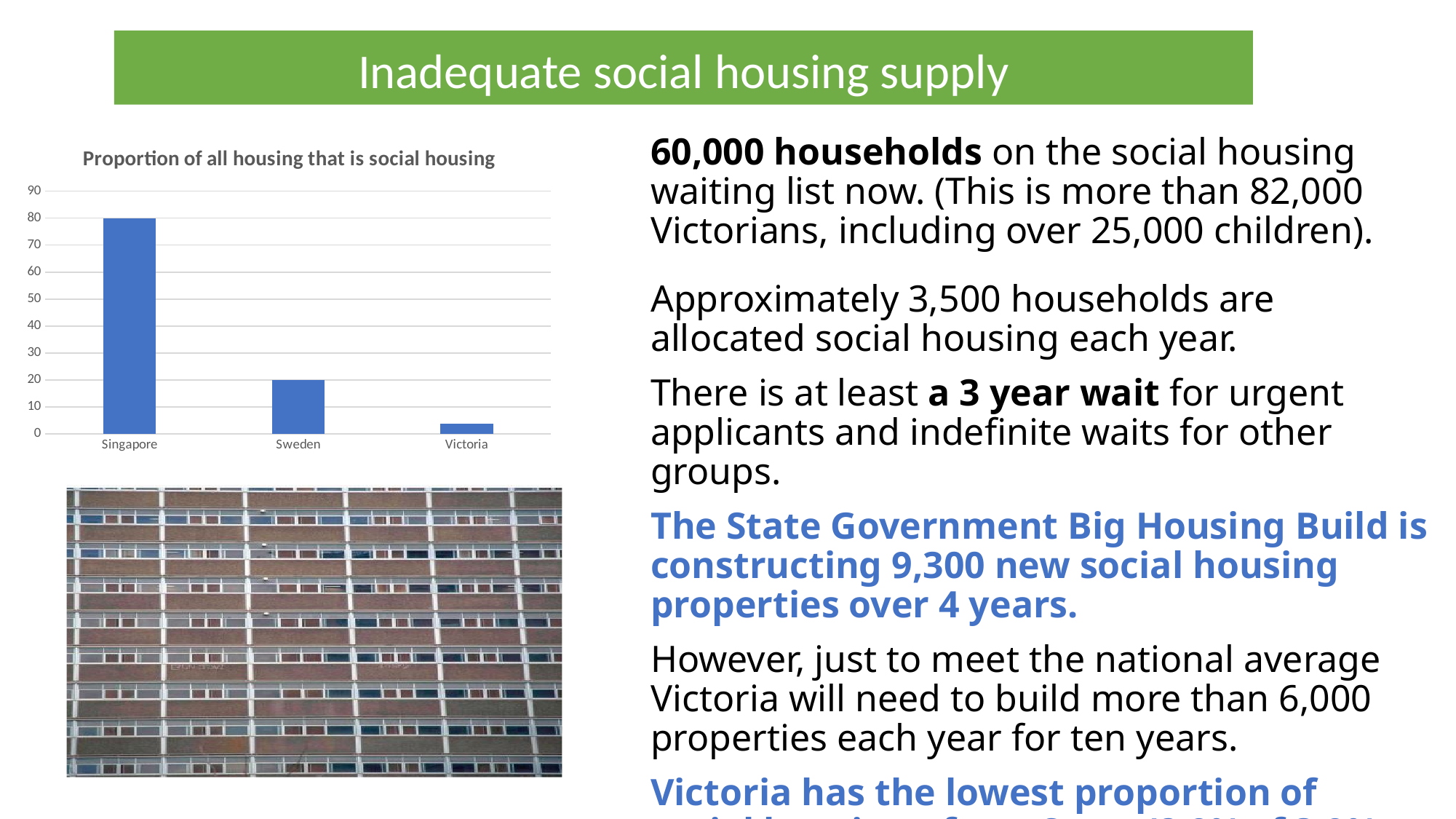
What kind of chart is shown on the slide? bar chart Is the value for Victoria greater or less than 10? less Which is larger, the value for Sweden or the value for Victoria? Sweden Do the values rise or fall from left to right across the categories? fall How many categories are shown in the chart? 3 What is the value for Sweden in the chart? 20 Is the value for Singapore greater or less than 50? greater What is the title of the chart? Proportion of all housing that is social housing Which category has the lowest value in the chart? Victoria What is the difference between the values for Singapore and Sweden? 60 What is the value for Singapore in the chart? 80 Which category has the highest value in the chart? Singapore